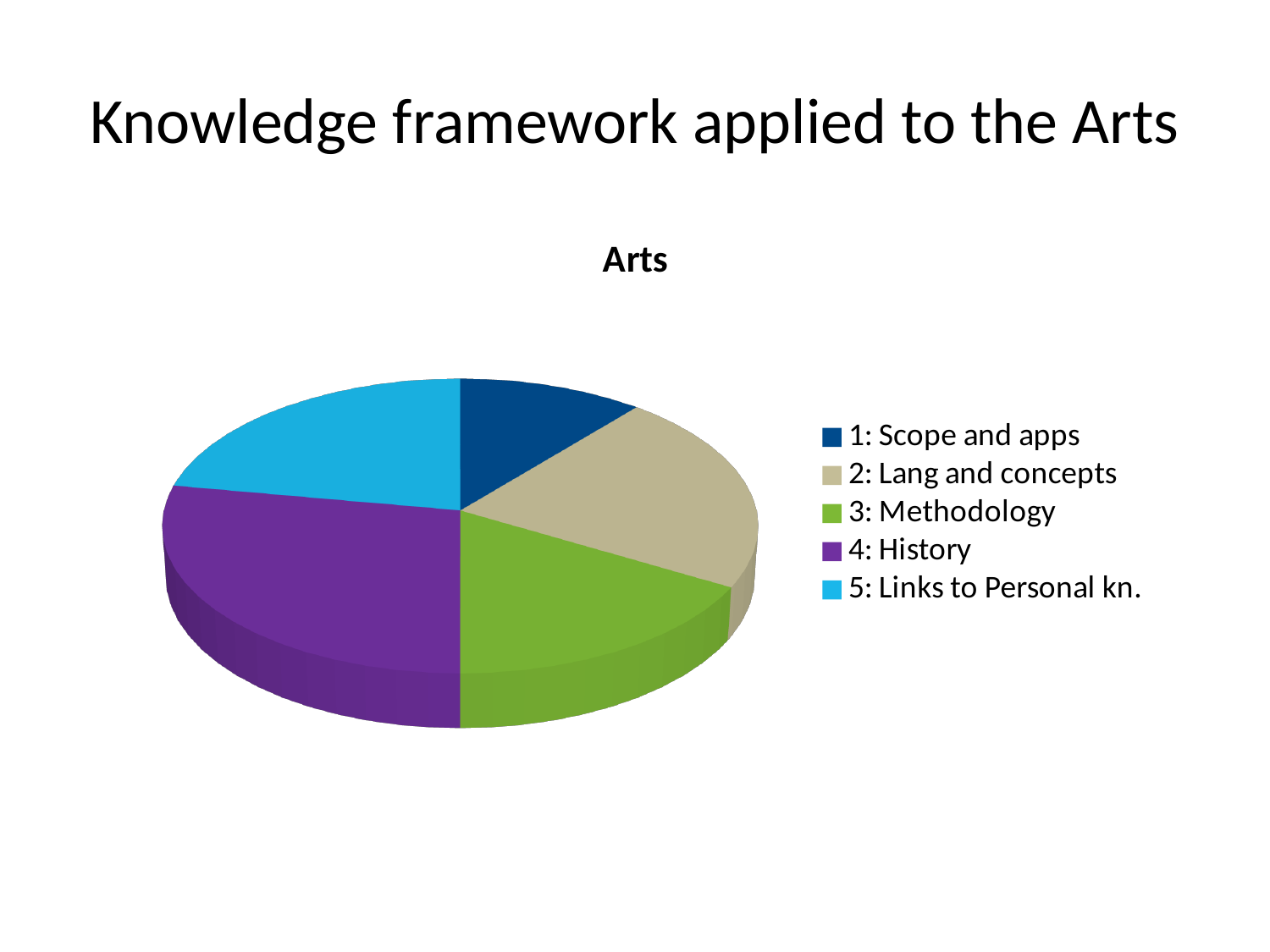
Which slice is larger, 4: History or 1: Scope and apps? 4: History What kind of chart is shown on the slide? pie chart Which slice is larger, 4: History or 2: Lang and concepts? 4: History How many entries does the legend list? 5 Which category has the largest slice of the pie? 4: History Which slice is larger, 3: Methodology or 1: Scope and apps? 3: Methodology Which colour represents 4: History in the pie chart? purple Which category has the smallest slice of the pie? 1: Scope and apps What is the title of the chart? Arts How many slices does the pie chart have? 5